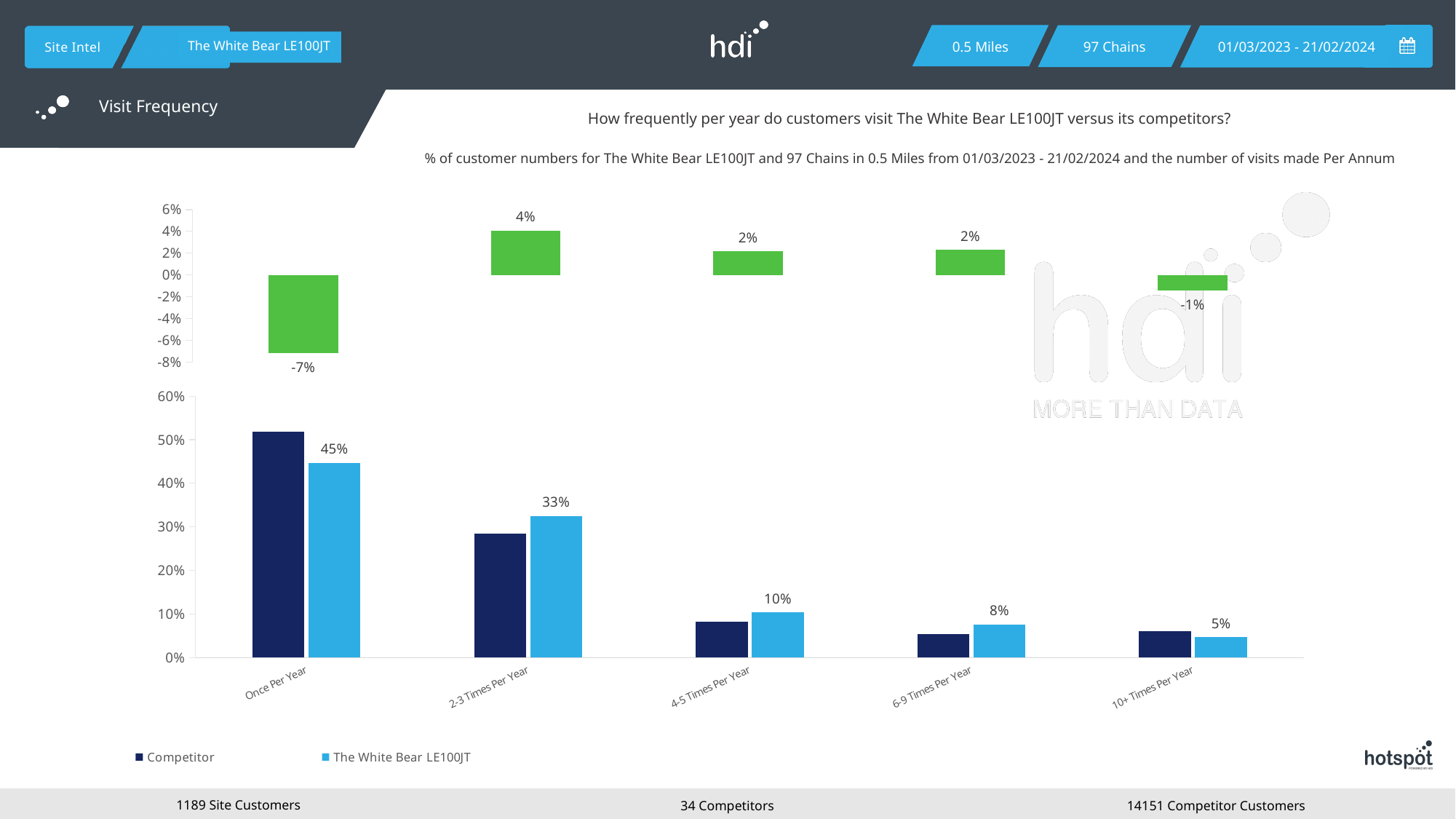
In the bottom chart, which category has the highest value for The White Bear LE100JT? Once Per Year In the top chart, which category has the lowest value? Once Per Year In the top chart, what is the value shown for the 2-3 Times Per Year category? 4% In the bottom chart, what is the value for The White Bear LE100JT in the 2-3 Times Per Year category? 33% In the bottom chart, what is the difference between The White Bear LE100JT values for Once Per Year and 2-3 Times Per Year? 12% In the bottom chart, is the Competitor value for Once Per Year greater or less than 50%? greater In the top chart, what is the value shown for the Once Per Year category? -7% How many series does the legend of the bottom chart list? 2 How many categories are shown on the x axis of the bottom chart? 5 In the bottom chart, what is the value for The White Bear LE100JT in the 10+ Times Per Year category? 5% In the bottom chart, what is the value for The White Bear LE100JT in the Once Per Year category? 45% In the bottom chart, which is larger for Once Per Year: the Competitor bar or The White Bear LE100JT bar? Competitor